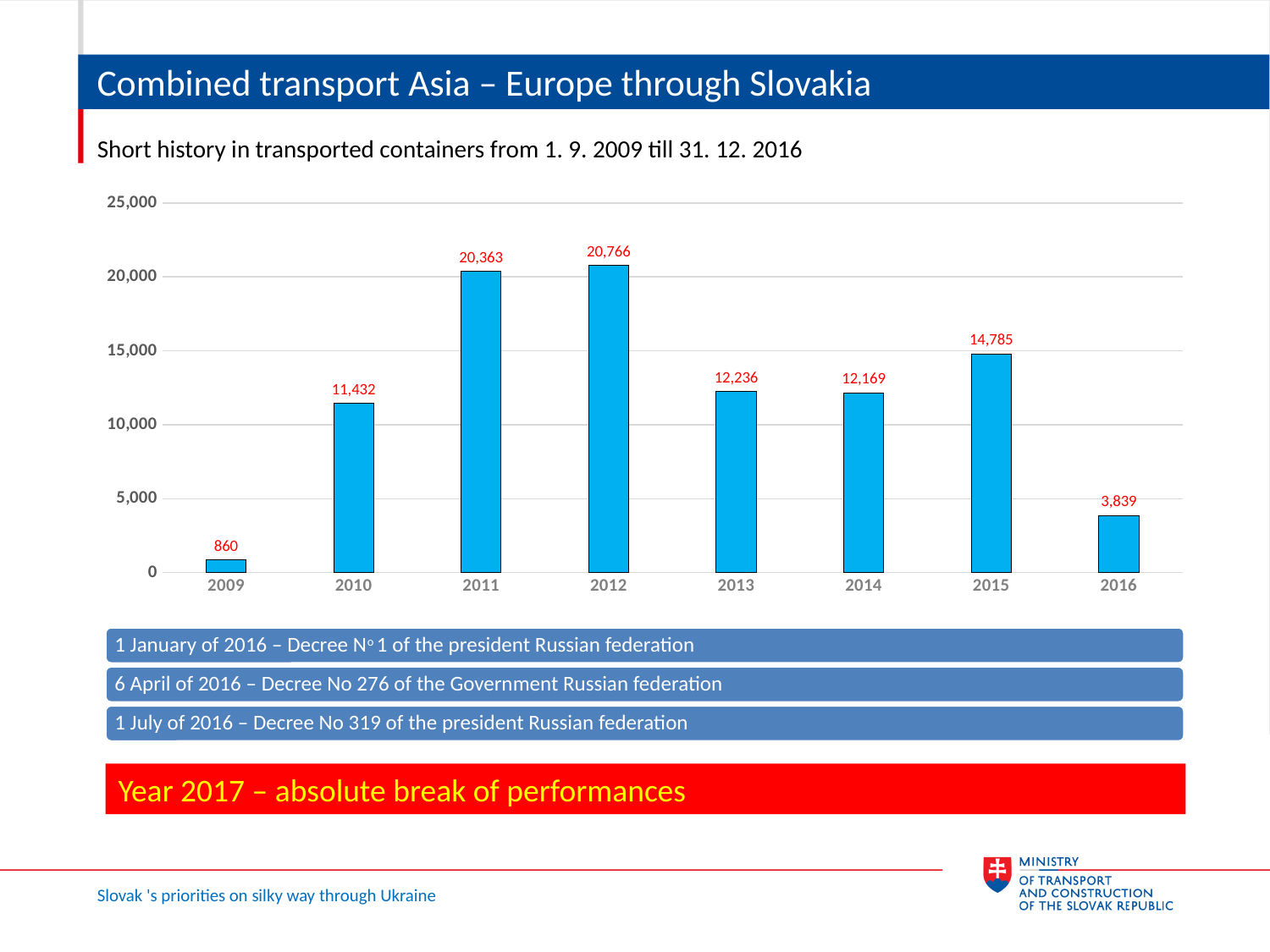
What is the value shown for 2016? 3,839 What is the value shown for 2009? 860 How many years are shown on the x axis of the chart? 8 What is the difference between the values for 2015 and 2016? 10,946 Which year has the larger value, 2013 or 2014? 2013 Which year has the lowest value in the chart? 2009 Do the values rise or fall from 2012 to 2013? fall Is the value for 2015 greater or less than 15,000? less What is the difference between the values for 2012 and 2011? 403 How many containers were transported in 2011? 20,363 Which year has the highest value in the chart? 2012 What type of chart is shown on the slide? bar chart